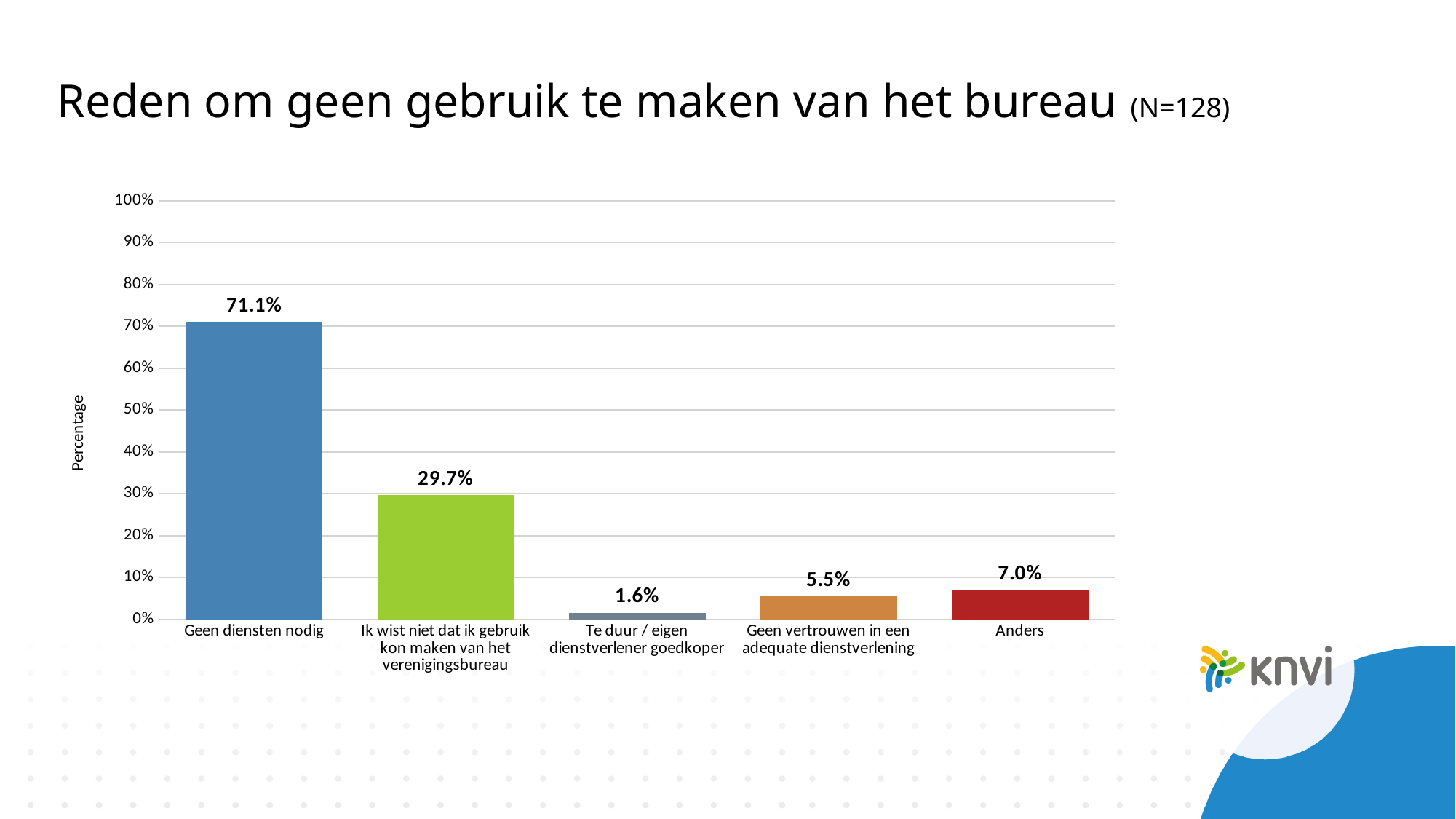
What is the value for "Te duur / eigen dienstverlener goedkoper"? 1.6% How many categories are shown in the chart? 5 What is the value for "Anders"? 7.0% What kind of chart is shown on the slide? bar chart Is the value for "Geen diensten nodig" greater or less than 60%? greater What is the label of the vertical axis? Percentage Which is larger: "Anders" or "Geen vertrouwen in een adequate dienstverlening"? Anders What is the difference between "Geen diensten nodig" and "Ik wist niet dat ik gebruik kon maken van het verenigingsbureau"? 41.4% Which category has the lowest value? Te duur / eigen dienstverlener goedkoper Which category has the highest value? Geen diensten nodig What is the value for "Ik wist niet dat ik gebruik kon maken van het verenigingsbureau"? 29.7% What is the value for "Geen diensten nodig"? 71.1%